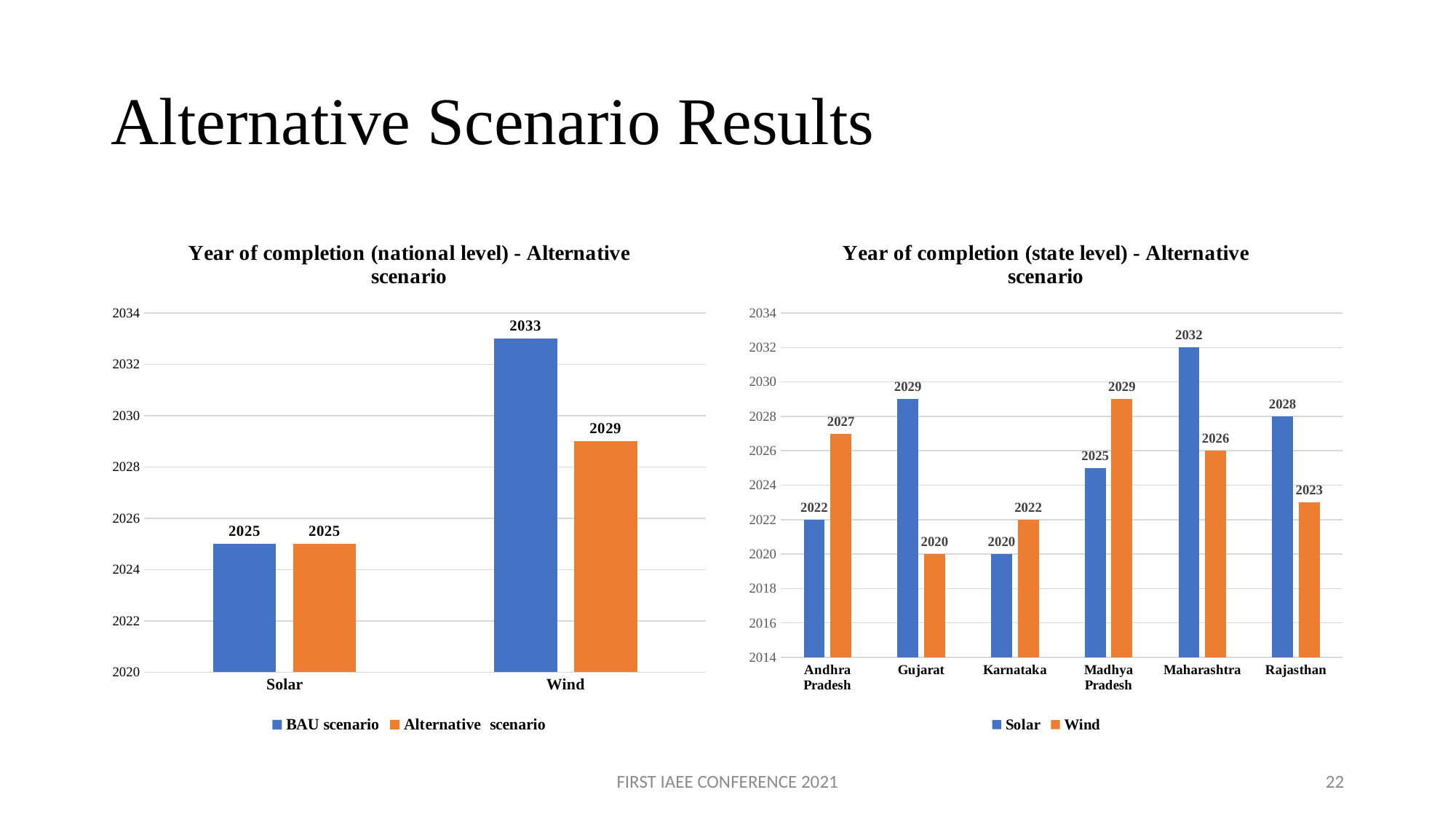
In the 'Year of completion (state level) - Alternative scenario' chart, how many states are shown on the x axis? 6 In the 'Year of completion (state level) - Alternative scenario' chart, which state has the highest Solar value? Maharashtra In the 'Year of completion (state level) - Alternative scenario' chart, what is the Solar value for Maharashtra? 2032 In the 'Year of completion (national level) - Alternative scenario' chart, what is the value for Wind under the BAU scenario? 2033 What kind of chart is the 'Year of completion (state level) - Alternative scenario' chart? Bar chart In the 'Year of completion (state level) - Alternative scenario' chart, which state has the lowest Wind value? Gujarat In the 'Year of completion (national level) - Alternative scenario' chart, what is the difference between the BAU scenario and Alternative scenario values for Wind? 4 In the 'Year of completion (national level) - Alternative scenario' chart, how many series does the legend list? 2 In the 'Year of completion (state level) - Alternative scenario' chart, what is the Wind value for Rajasthan? 2023 In the 'Year of completion (national level) - Alternative scenario' chart, what is the value for Wind under the Alternative scenario? 2029 In the 'Year of completion (national level) - Alternative scenario' chart, what is the value for Solar under the BAU scenario? 2025 In the 'Year of completion (state level) - Alternative scenario' chart, is the Solar value for Gujarat or the Wind value for Gujarat larger? Solar